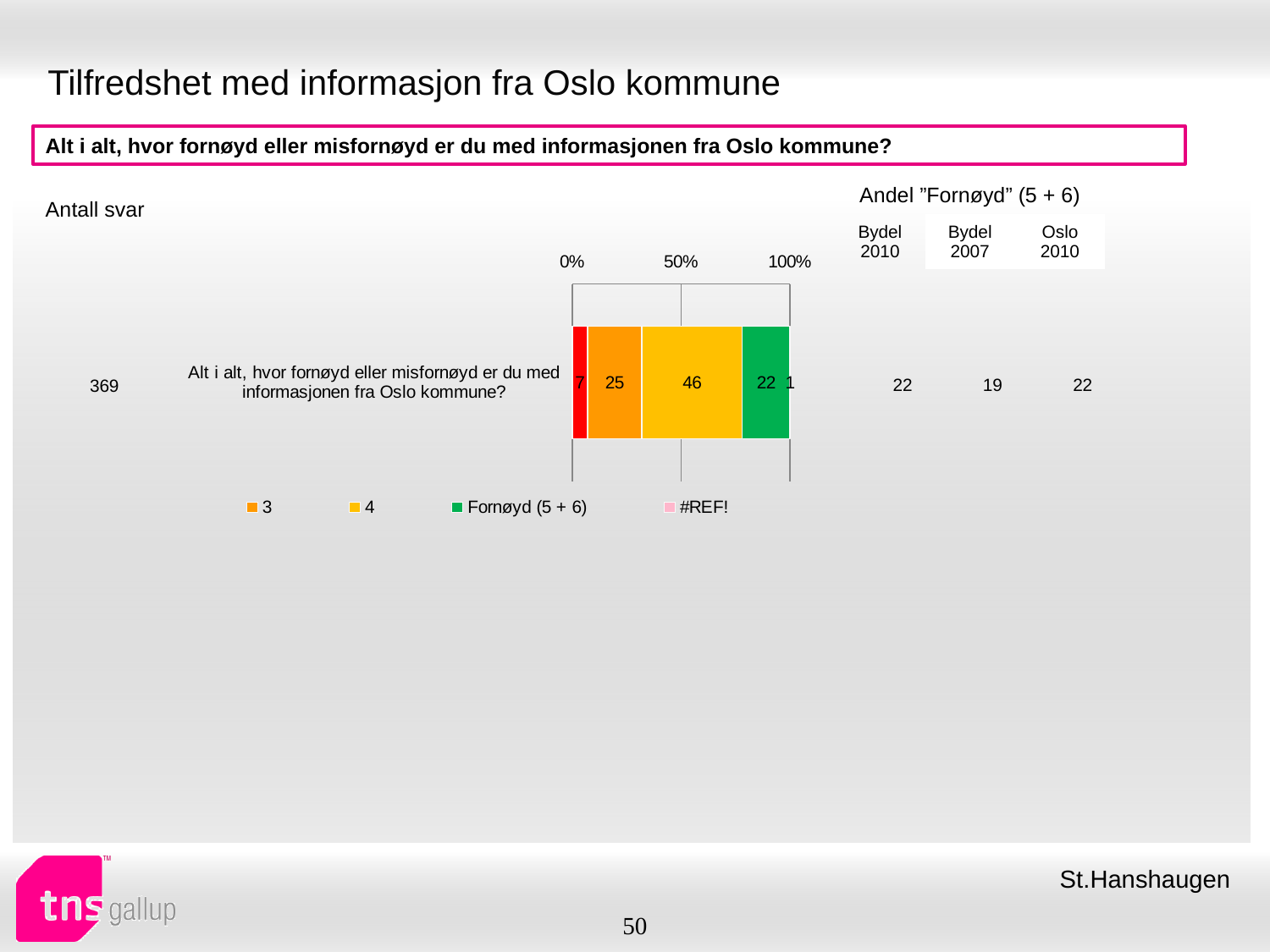
What is the "Antall svar" (number of responses) shown for the question? 369 How many bars does the chart contain? 1 Which segment of the bar has the largest value? 4 What is the value of the segment labelled "3" in the bar? 25 Which is larger, the "3" segment or the "Fornøyd (5 + 6)" segment? 3 What is the value of the red segment at the left end of the bar? 7 Which legend entry is shown in green? Fornøyd (5 + 6) How many entries does the legend list? 4 What is the value of the "Fornøyd (5 + 6)" segment in the bar? 22 What kind of chart is shown on the slide? bar chart What is the difference between the "4" segment and the "3" segment? 21 What is the value of the segment labelled "4" in the bar? 46